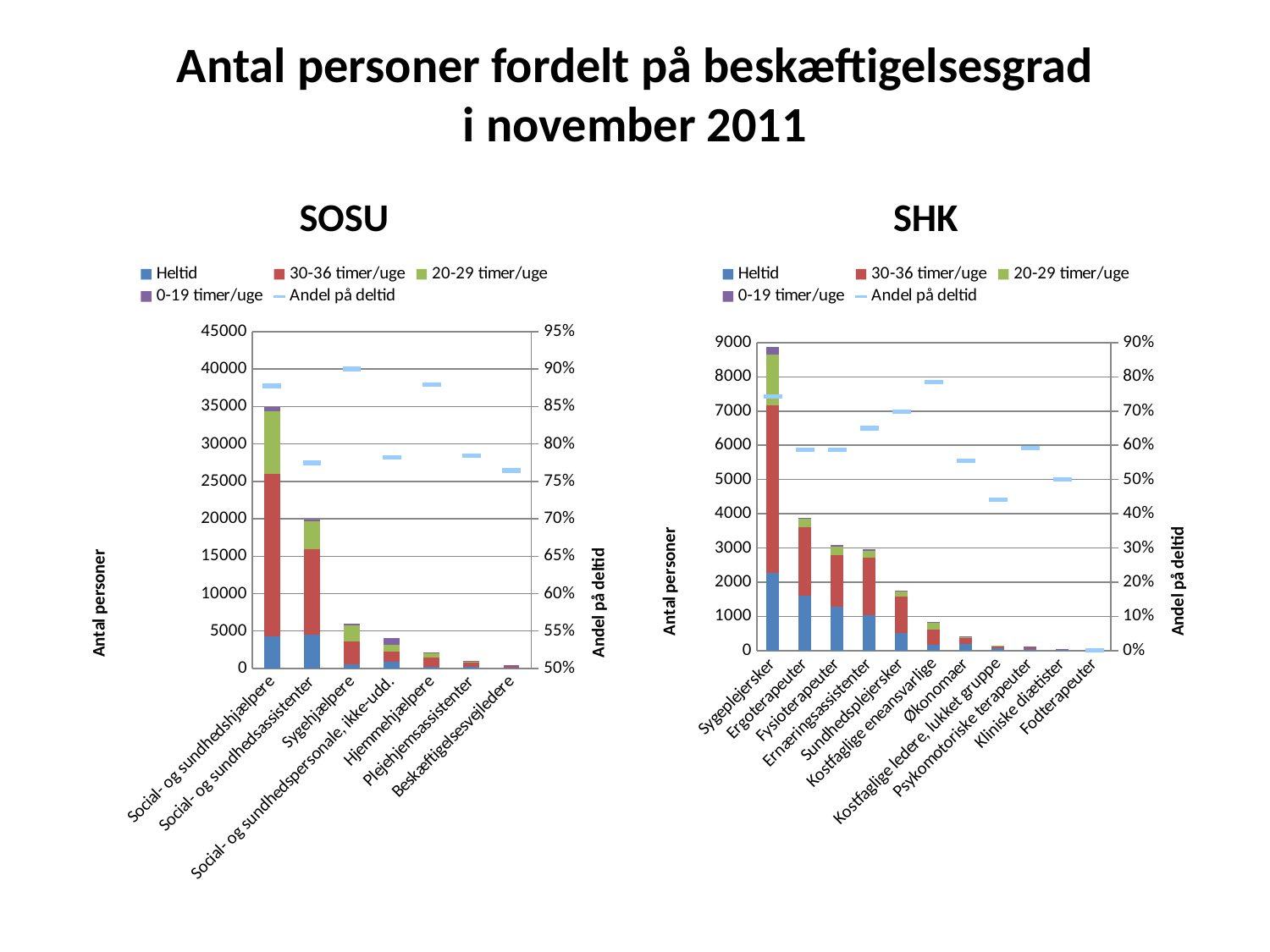
How many categories are shown on the x axis of the SOSU chart? 7 In the SHK chart, which has the taller stacked bar, Sygeplejersker or Ergoterapeuter? Sygeplejersker What is the label of the right-hand vertical axis on the SHK chart? Andel på deltid In the SHK chart, is the Andel på deltid value for Kostfaglige ledere, lukket gruppe greater or less than 50%? less What kind of chart is the SOSU chart? bar chart How many categories are shown on the x axis of the SHK chart? 11 In the SOSU chart, which category has the tallest stacked bar? Social- og sundhedshjælpere In the SOSU chart, which category has the highest Andel på deltid value? Sygehjælpere In the SHK chart, which category has the tallest stacked bar? Sygeplejersker In the SOSU chart, is the total bar for Social- og sundhedshjælpere greater or less than 30000? greater In the SHK chart, is the total bar for Sygeplejersker greater or less than 8000? greater How many series does the legend of the SHK chart list? 5